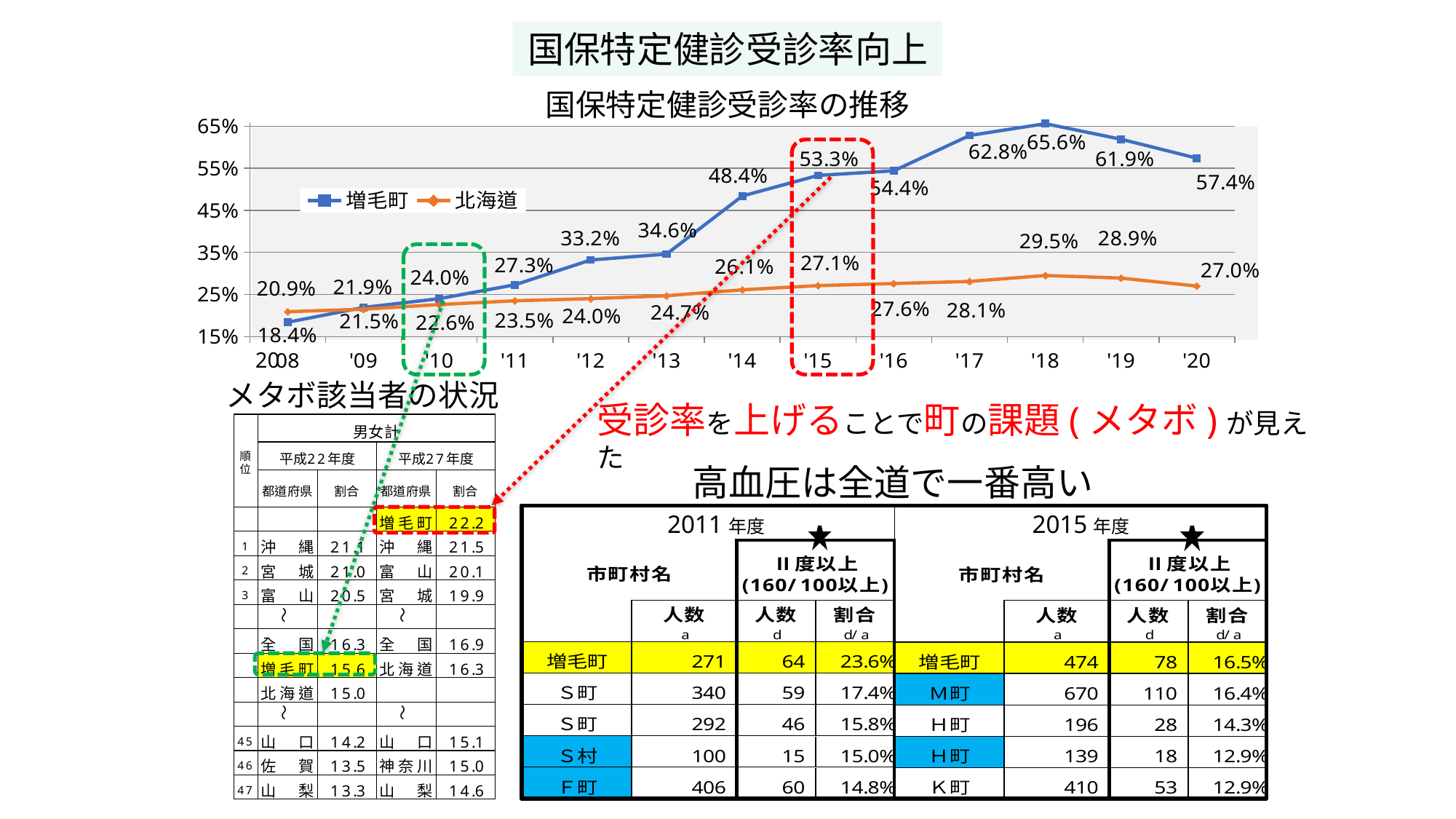
Does the value for 増毛町 generally rise or fall from 2008 to '18 in the 国保特定健診受診率の推移 chart? rise How many series does the legend of the 国保特定健診受診率の推移 chart list? 2 What is the value for 北海道 in '18 in the 国保特定健診受診率の推移 chart? 29.5% In 2008, which series has the larger value in the 国保特定健診受診率の推移 chart, 増毛町 or 北海道? 北海道 What is the difference between 増毛町 and 北海道 in '20 in the 国保特定健診受診率の推移 chart? 30.4% What are the two series named in the legend of the 国保特定健診受診率の推移 chart? 増毛町 and 北海道 How many years are plotted along the x axis of the 国保特定健診受診率の推移 chart? 13 What type of chart is 国保特定健診受診率の推移? line chart What is the value for 増毛町 in '10 in the 国保特定健診受診率の推移 chart? 24.0% In which year does 増毛町 reach its highest value in the 国保特定健診受診率の推移 chart? '18 What is the value for 増毛町 in '15 in the 国保特定健診受診率の推移 chart? 53.3% In which year is the value for 増毛町 lowest in the 国保特定健診受診率の推移 chart? 2008